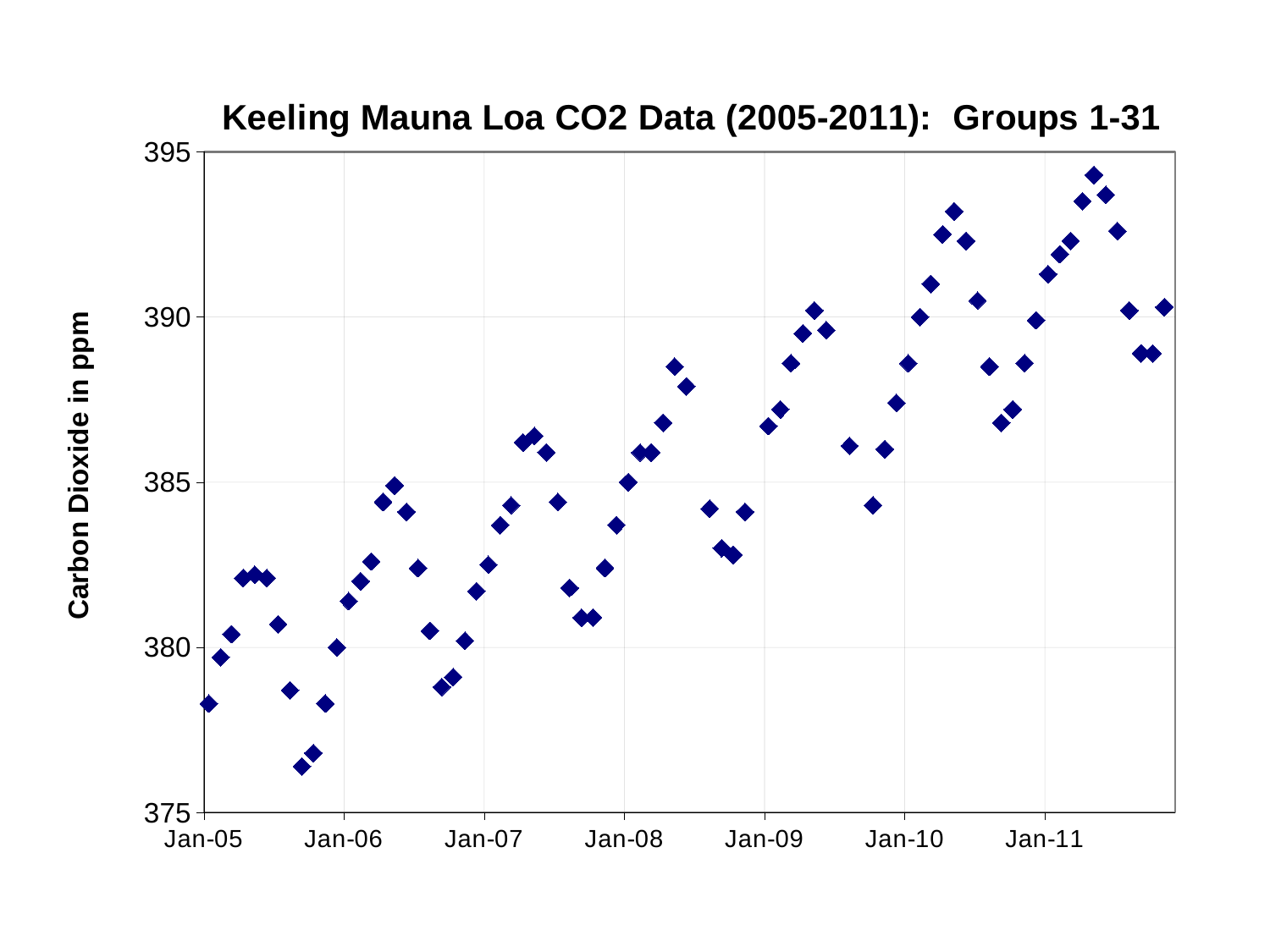
What is the label of the vertical axis? Carbon Dioxide in ppm How many year labels are shown on the horizontal axis? 7 Is the lowest point on the chart greater or less than 380? less Is the value of the point at Jan-09 greater or less than 385? greater In which year does the highest CO2 value on the chart occur? 2011 Is the value of the point at Jan-07 greater or less than 385? less What kind of chart is shown on the slide? scatter plot In which year does the lowest CO2 value on the chart occur? 2005 Do the CO2 values generally rise or fall from Jan-05 to the end of 2011? rise What is the title of the chart? Keeling Mauna Loa CO2 Data (2005-2011): Groups 1-31